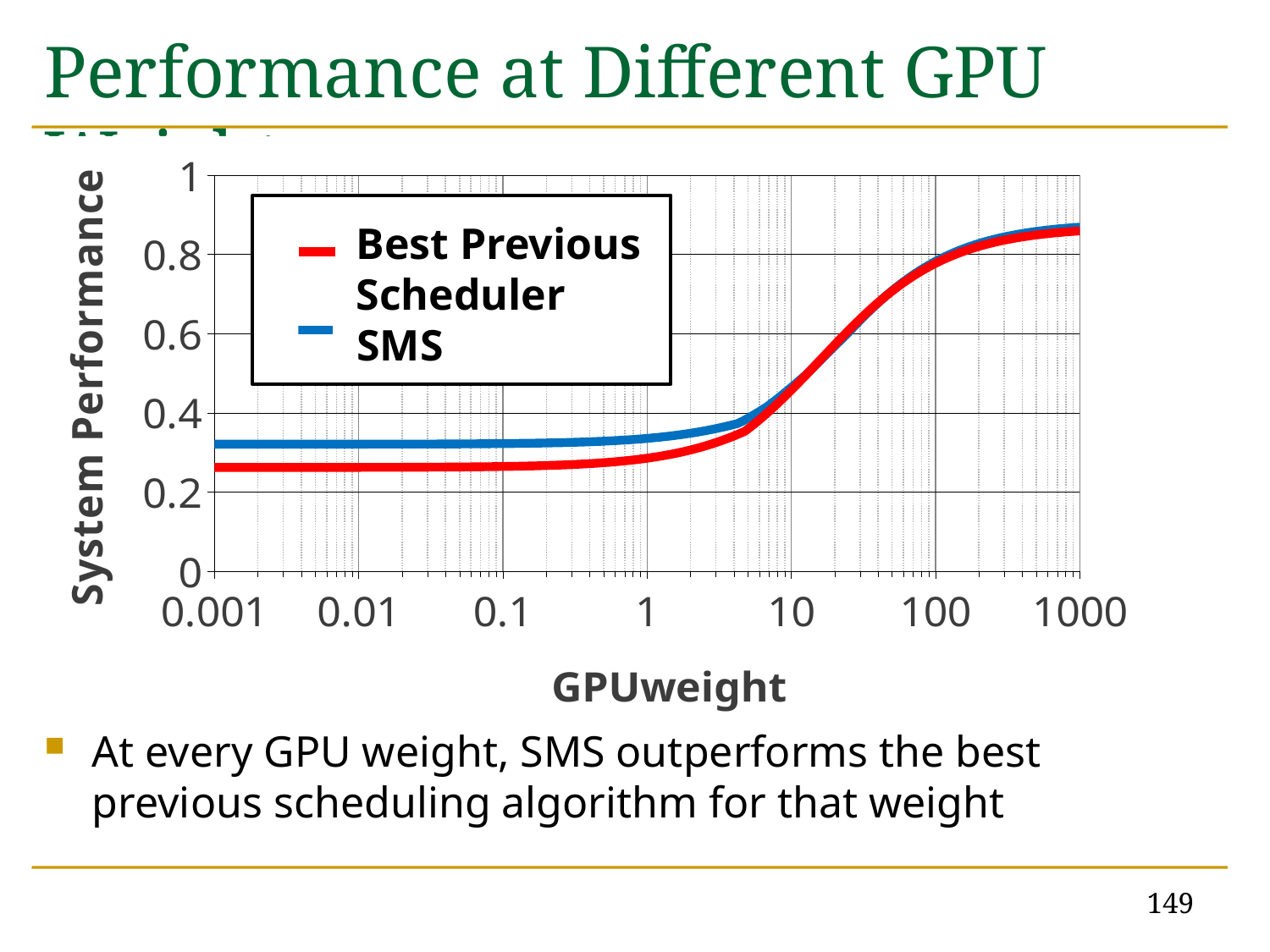
Is the System Performance of SMS at a GPUweight of 1000 greater or less than 0.8? greater Is the System Performance of Best Previous Scheduler at a GPUweight of 0.001 greater or less than 0.2? greater Does the SMS line rise or fall as GPUweight increases from 0.001 to 1000? rise Is the System Performance of SMS at a GPUweight of 0.001 greater or less than 0.4? less What is the label of the x axis? GPUweight What kind of chart is shown on the slide? line chart At a GPUweight of 1, which series has the higher System Performance, SMS or Best Previous Scheduler? SMS At a GPUweight of 0.01, which series has the higher System Performance, SMS or Best Previous Scheduler? SMS How many series does the legend list? 2 What colour is the SMS line? blue Does the Best Previous Scheduler line rise or fall as GPUweight increases from 1 to 100? rise